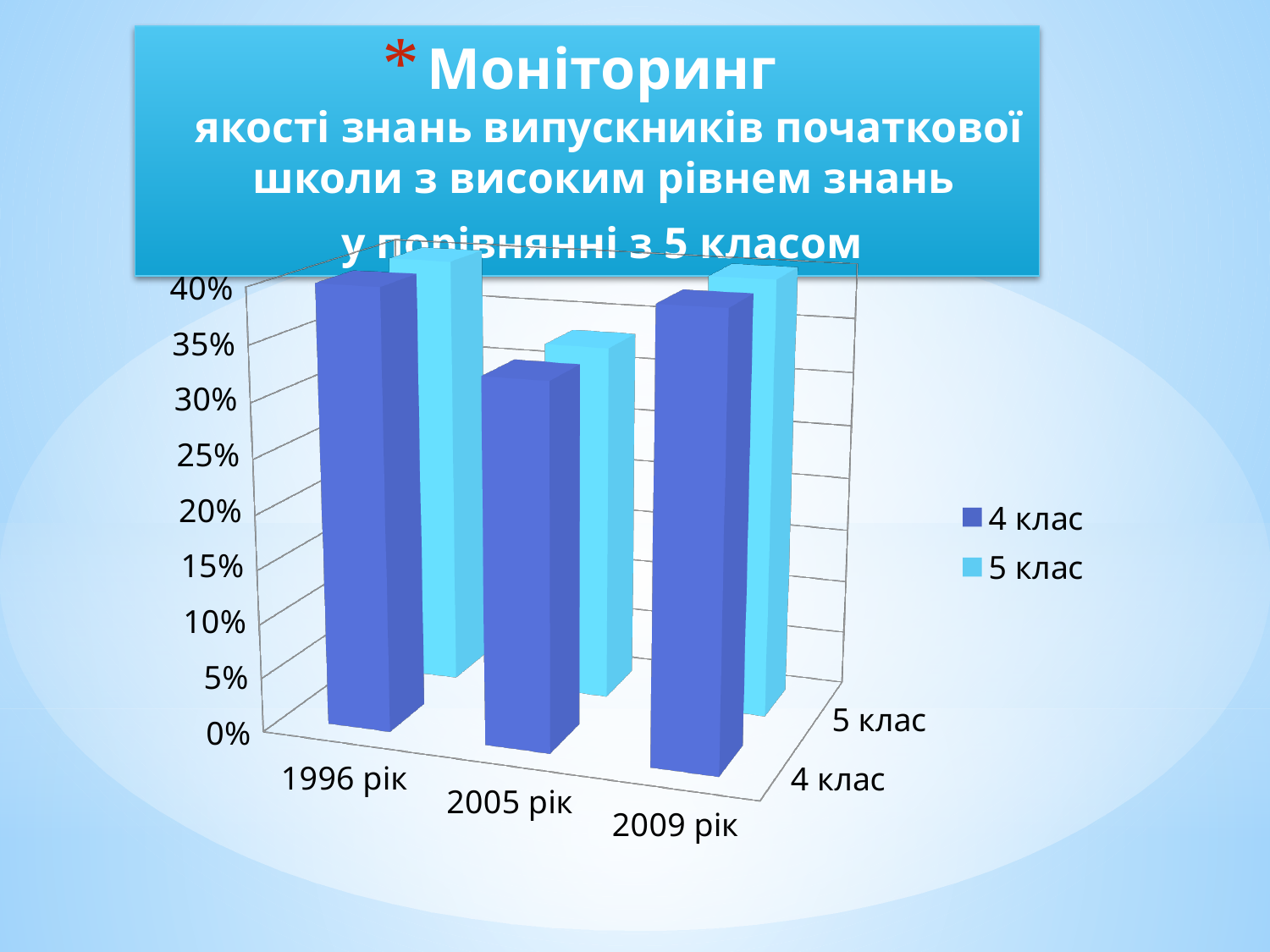
Is the value for 5 клас in 1996 рік greater or less than 35%? greater Does the value for 4 клас rise or fall from 1996 рік to 2005 рік? fall What are the two series named in the legend? 4 клас and 5 клас Is the value for 4 клас in 2005 рік greater or less than 35%? less How many year categories are shown on the x axis? 3 Which year has the lowest value for 4 клас? 2005 рік Which colour represents the 5 клас series? light blue Which is larger for 4 клас: the value for 1996 рік or for 2005 рік? 1996 рік Is the value for 4 клас in 1996 рік greater or less than 30%? greater How many series does the legend list? 2 What kind of chart is shown on the slide? bar chart